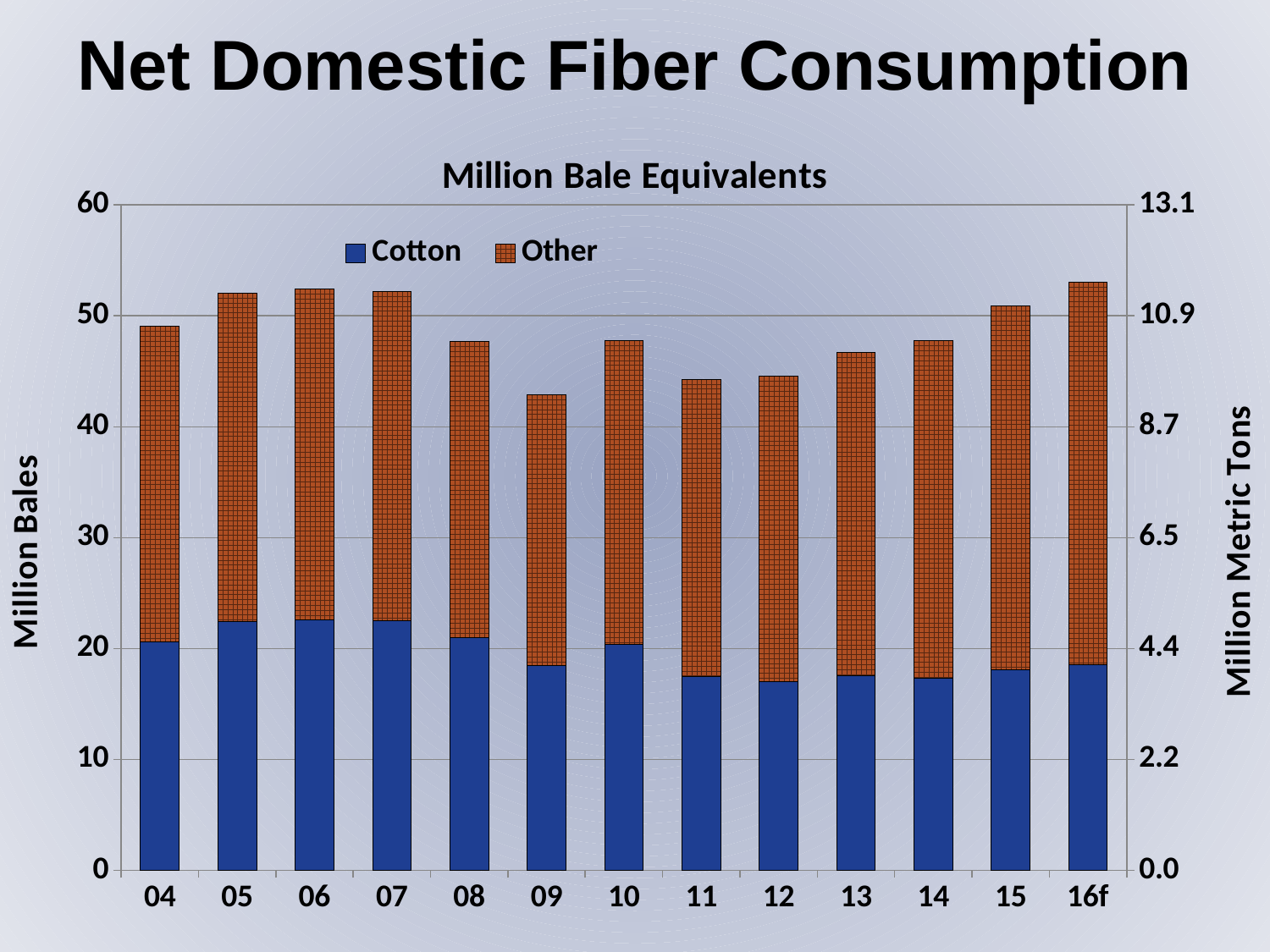
Is the total bar height for 09 greater or less than 40 million bales? greater Do the total bars rise or fall from 12 to 16f? rise What kind of chart is shown on the slide? stacked bar chart Which year has the lowest total bar? 09 Which has the larger total bar, 05 or 08? 05 How many years (categories) are shown on the x axis? 13 How many series does the legend list? 2 Is the total bar height for 11 greater or less than 50 million bales? less Is the Cotton value for 06 greater or less than 20 million bales? greater What are the two series named in the legend? Cotton and Other What is the label of the left vertical axis? Million Bales